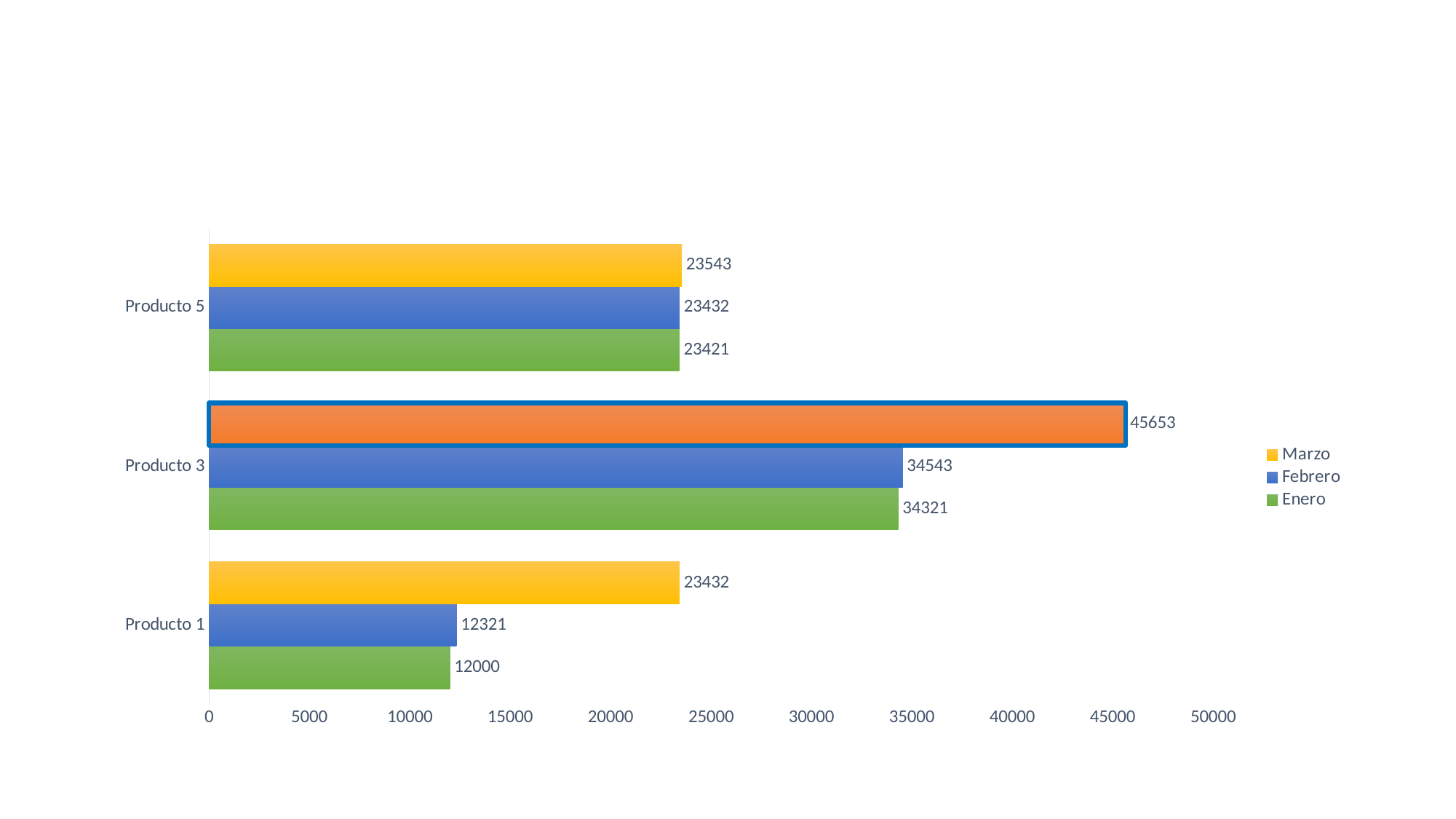
How many products are shown on the chart? 3 What is the Enero value for Producto 1? 12000 What kind of chart is shown on the slide? Bar chart What is the difference between the Marzo and Febrero values for Producto 3? 11110 Is the Enero value for Producto 3 greater or less than 30000? greater Which is larger: the Marzo value for Producto 1 or the Febrero value for Producto 1? Marzo value for Producto 1 What is the difference between the Febrero and Enero values for Producto 1? 321 How many series does the legend list? 3 Which product has the highest Marzo value? Producto 3 Which product has the lowest Enero value? Producto 1 What is the Marzo value for Producto 3? 45653 What is the Febrero value for Producto 5? 23432